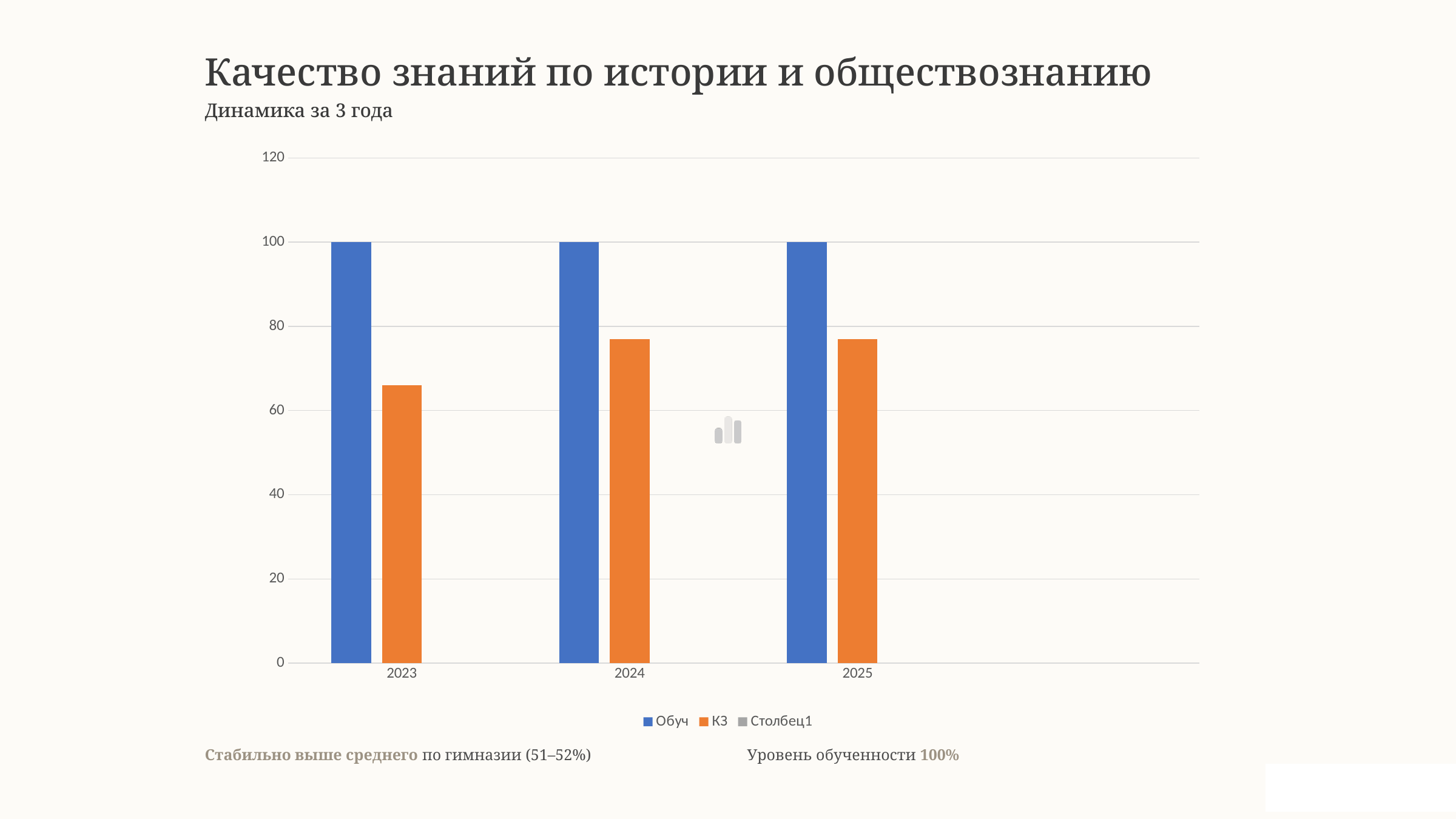
How many series does the legend list? 3 Is the value of КЗ for 2025 greater or less than 60? greater What is the title of the chart on the slide? Качество знаний по истории и обществознанию What kind of chart is shown on the slide? bar chart How many years (categories) are shown on the x axis? 3 Is the value of КЗ for 2024 greater or less than 80? less Is the value of КЗ for 2023 greater or less than 60? greater What is the value of Обуч for 2023? 100 What is the value of Обуч for 2025? 100 In which year is the КЗ value lowest? 2023 Which is larger: КЗ for 2023 or КЗ for 2024? 2024